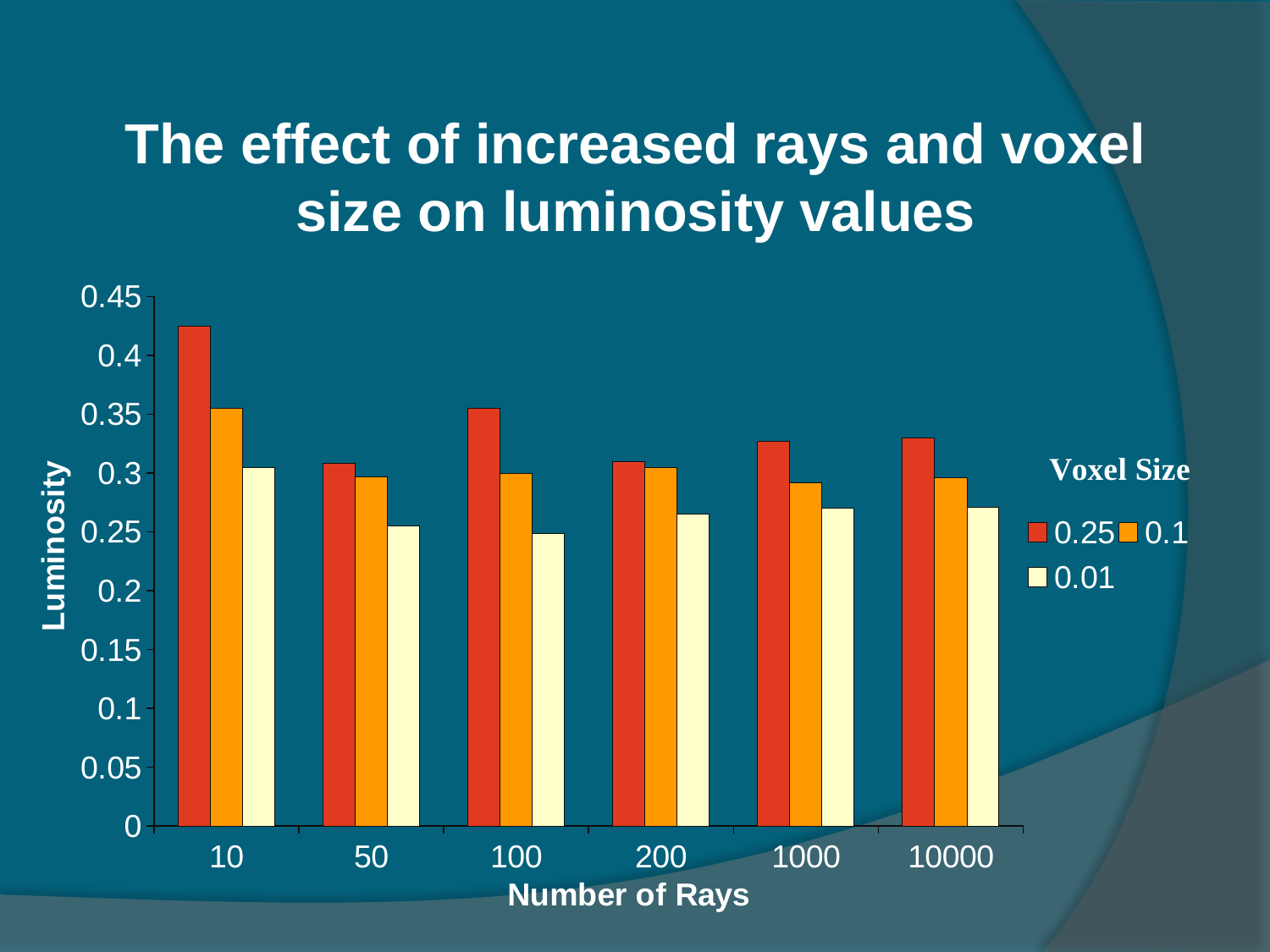
For which Number of Rays is the luminosity for voxel size 0.01 highest? 10 What kind of chart is shown on the slide? bar chart What is the title of the legend? Voxel Size At 100 rays, which voxel size has the larger luminosity, 0.25 or 0.1? 0.25 Is the luminosity for voxel size 0.25 at 10 rays greater or less than 0.4? greater How many Number of Rays categories are shown on the x axis? 6 How many series does the legend list? 3 Is the luminosity for voxel size 0.25 at 1000 rays greater or less than 0.3? greater At 10 rays, which voxel size has the larger luminosity, 0.25 or 0.01? 0.25 Does the luminosity for voxel size 0.25 rise or fall from 10 rays to 50 rays? fall For which Number of Rays is the luminosity for voxel size 0.25 highest? 10